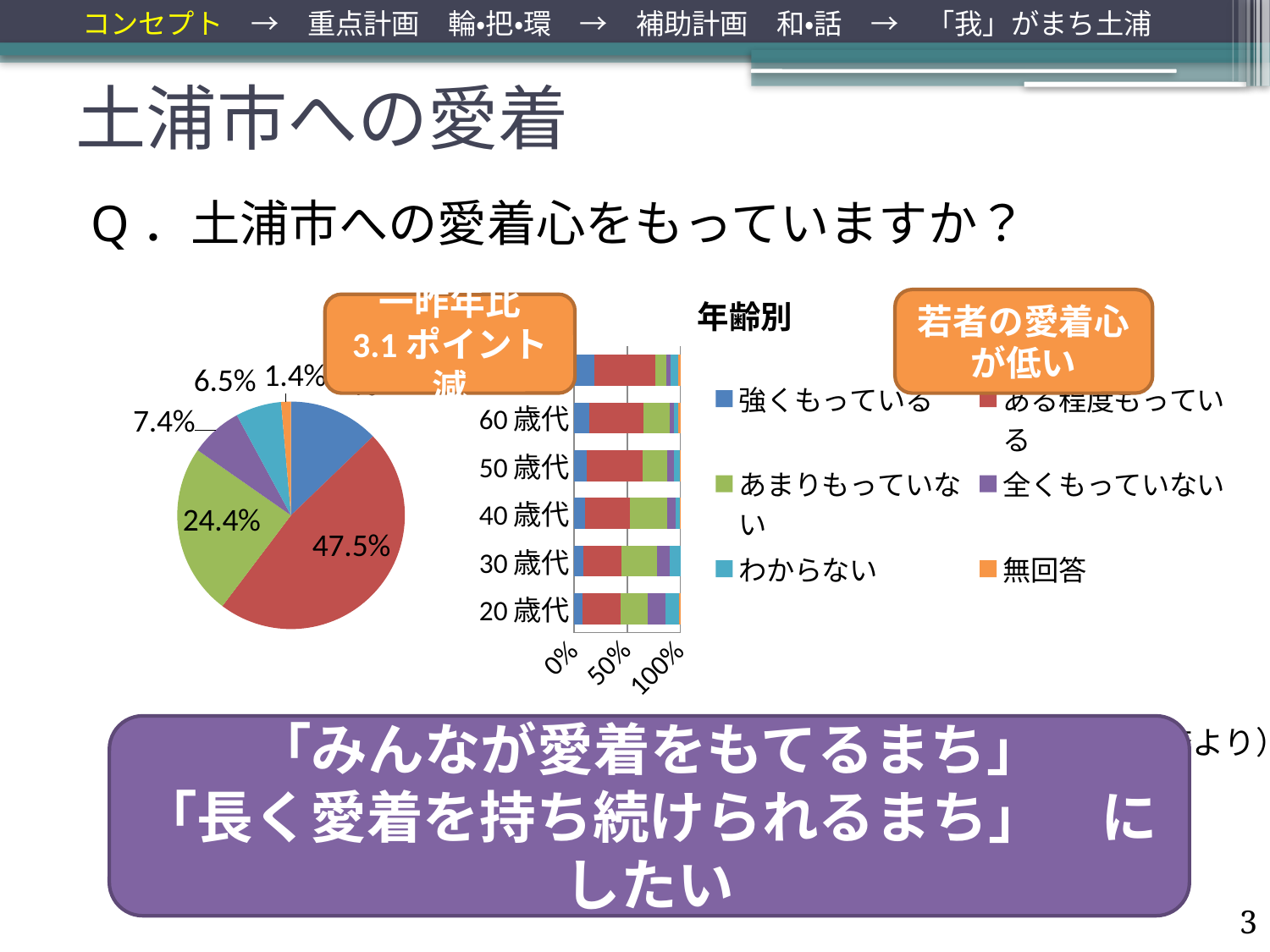
In the pie chart, which labelled category has the smallest share? 無回答 In the pie chart, what percentage is shown for ある程度もっている (the red slice)? 47.5% In the pie chart, what percentage is shown for わからない (the light blue slice)? 6.5% In the pie chart, what percentage is shown for あまりもっていない (the green slice)? 24.4% In the pie chart, which is larger: the share for 全くもっていない or the share for わからない? 全くもっていない What is the title of the stacked bar chart on the right? 年齢別 In the pie chart, what is the difference between the shares for ある程度もっている and あまりもっていない? 23.1% What kind of chart is the chart on the left of the slide? Pie chart In the pie chart, what percentage is shown for 全くもっていない (the purple slice)? 7.4% How many entries does the legend list? 6 In the pie chart, what percentage is shown for 無回答 (the orange slice)? 1.4% In the pie chart, which category has the largest share? ある程度もっている